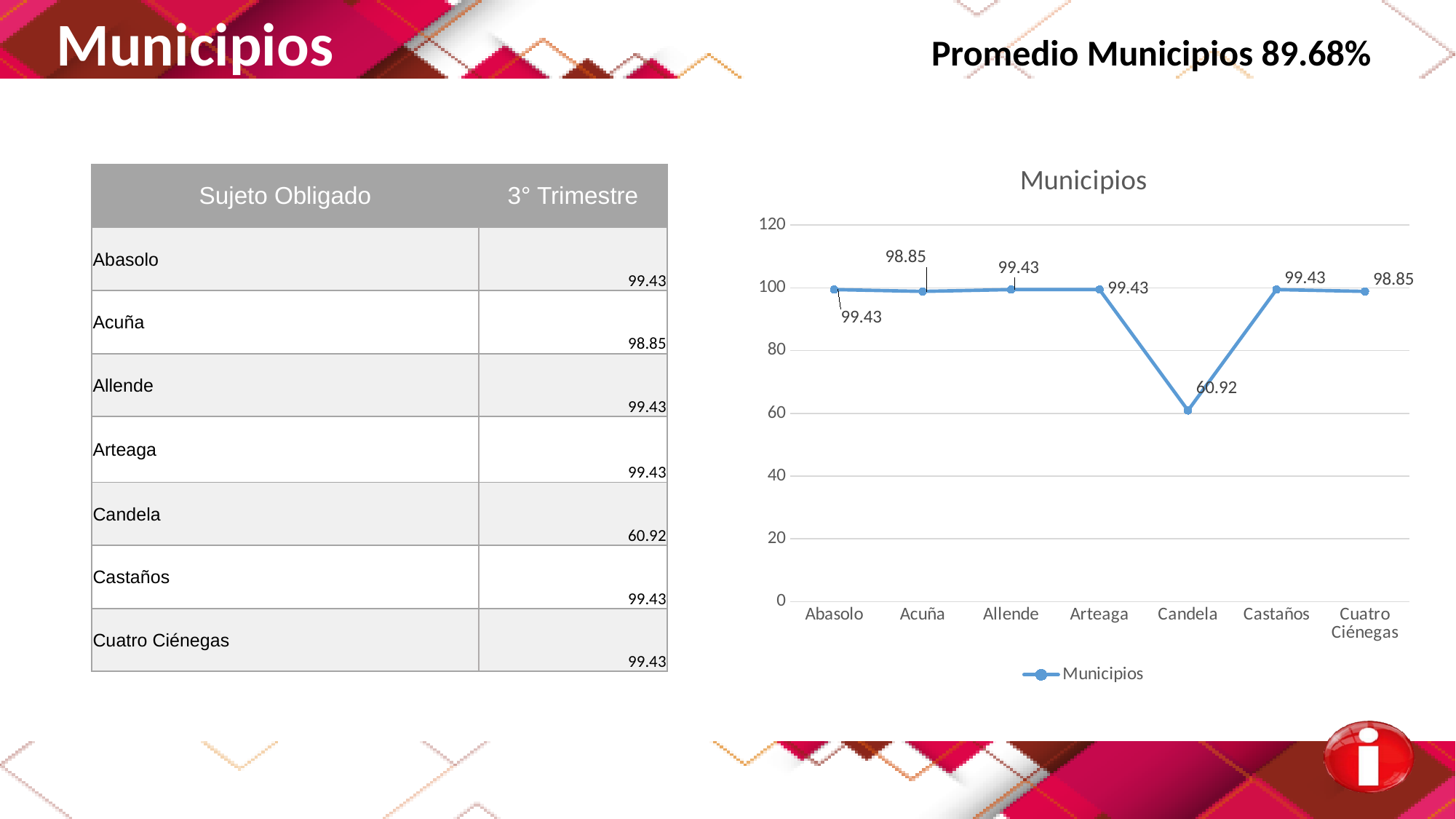
What is the difference between the values for Allende and Acuña in the Municipios chart? 0.58 What is the value for Candela in the Municipios chart? 60.92 How many series does the legend of the Municipios chart list? 1 What is the difference between the values for Arteaga and Candela in the Municipios chart? 38.51 Which is larger in the Municipios chart, the value for Castaños or the value for Candela? Castaños What is the value for Acuña in the Municipios chart? 98.85 How many municipalities are plotted on the x axis of the Municipios chart? 7 Which municipality has the lowest value in the Municipios chart? Candela What is the value for Abasolo in the Municipios chart? 99.43 What is the value for Castaños in the Municipios chart? 99.43 Is the value for Candela in the Municipios chart greater or less than 80? less What type of chart is shown on the slide? line chart